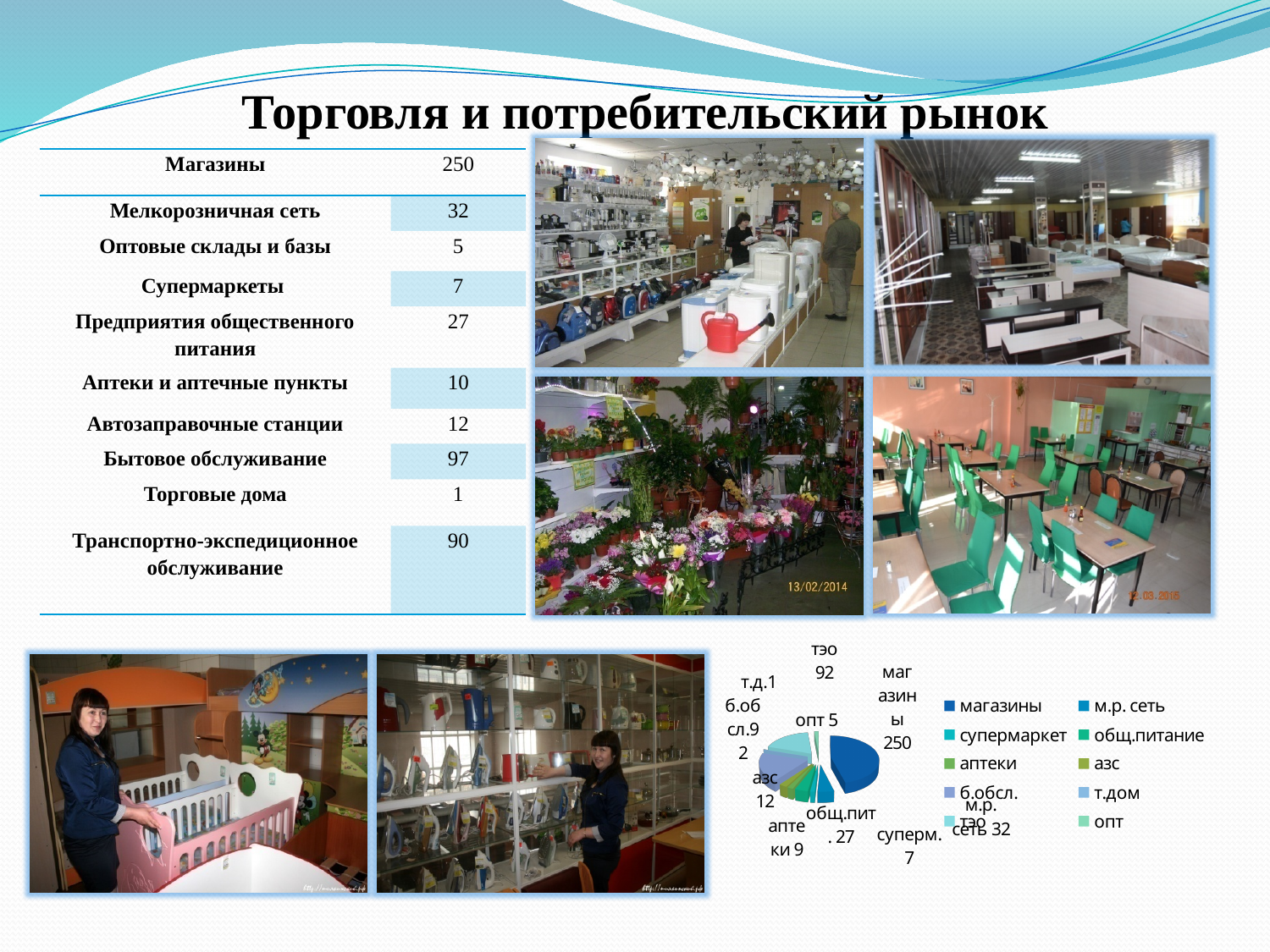
How many entries does the legend of the pie chart list? 10 In the pie chart, what value is shown for общ.пит.? 27 In the pie chart, what is the difference between the values for магазины and м.р. сеть? 218 Which category has the largest slice in the pie chart? магазины What kind of chart is shown at the bottom right of the slide? pie chart In the pie chart, which is larger: магазины or м.р. сеть? магазины In the pie chart, what value is shown for м.р. сеть? 32 In the pie chart, what value is shown for тэо? 92 In the pie chart legend, which entry is listed first? магазины In the pie chart, what value is shown for опт? 5 In the pie chart, what value is shown for азс? 12 In the pie chart, what value is shown for магазины? 250